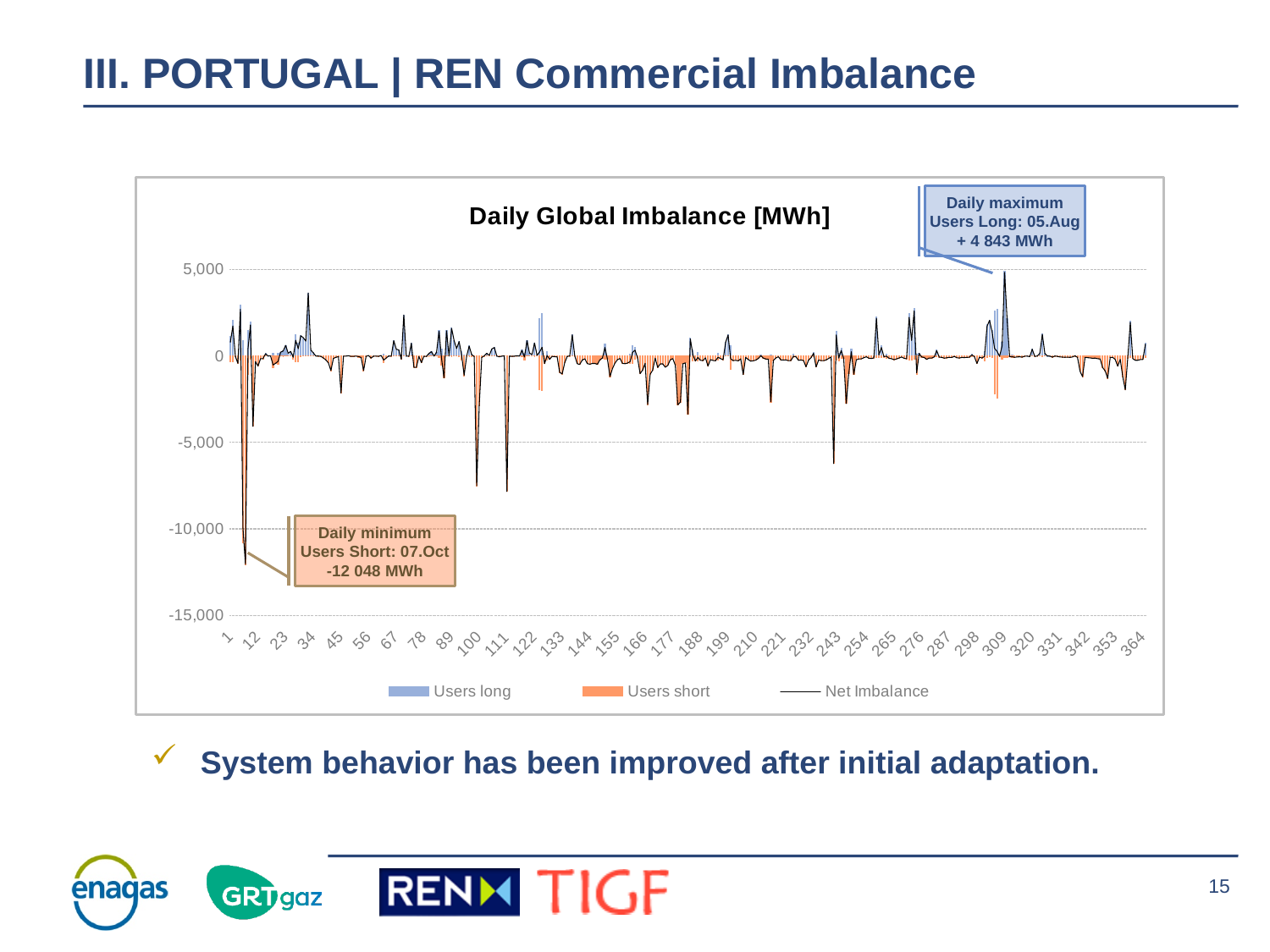
What is the daily maximum value for Users Long shown in the chart annotation? + 4 843 MWh What is the daily minimum value for Users Short shown in the chart annotation? -12 048 MWh What is the lowest value shown on the vertical axis of the chart? -15,000 What is the highest value shown on the vertical axis of the chart? 5,000 What is the difference between the annotated daily maximum (+4 843 MWh) and the annotated daily minimum (-12 048 MWh)? 16 891 MWh How many series does the chart legend list? 3 On which date did the daily maximum for Users Long occur? 05.Aug On which date did the daily minimum for Users Short occur? 07.Oct What are the three series named in the chart legend? Users long, Users short, Net Imbalance What is the title of the chart? Daily Global Imbalance [MWh] Is the lowest point of the Net Imbalance line greater or less than -10,000? less